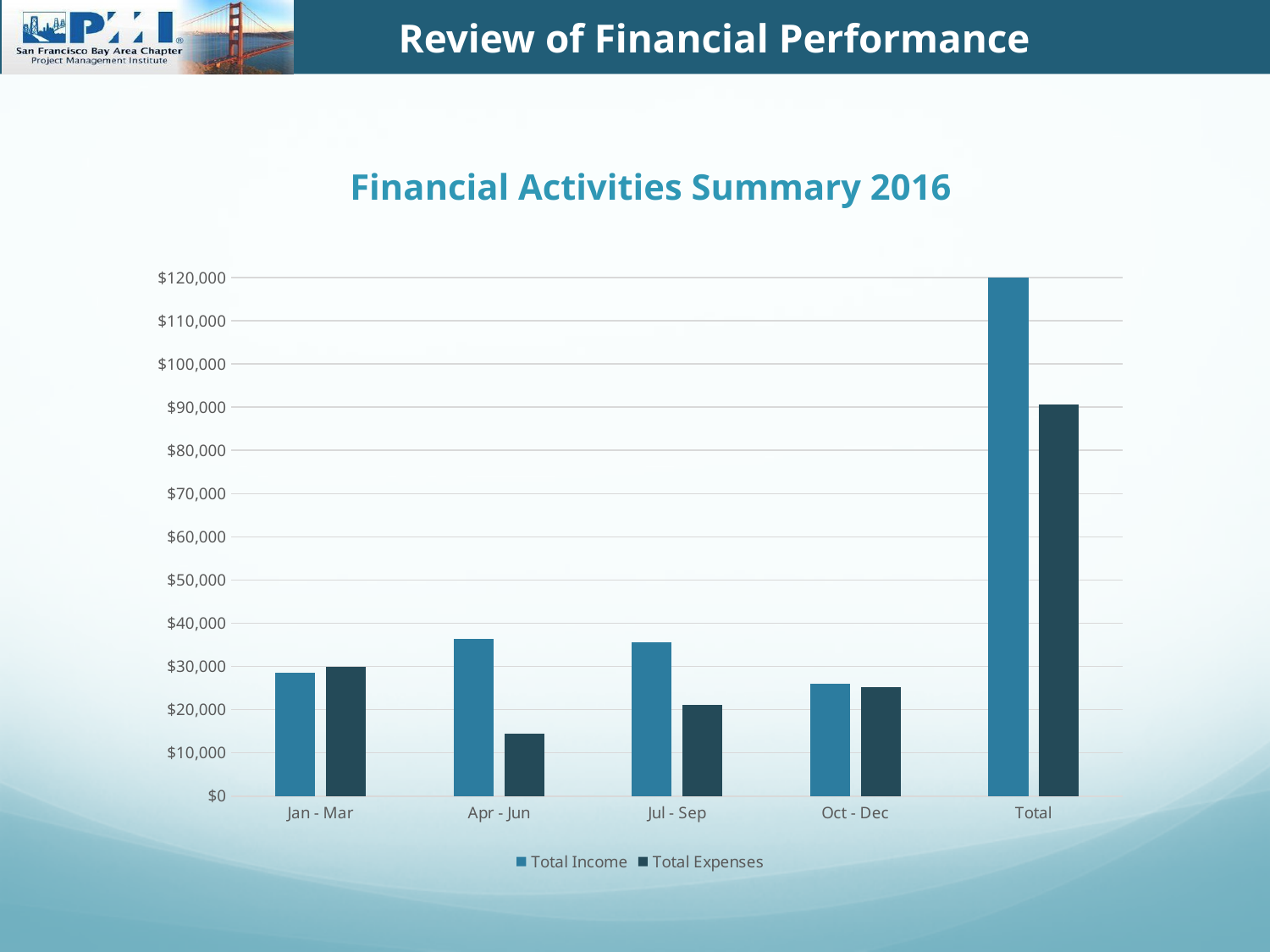
For Jul - Sep, which is larger, Total Income or Total Expenses? Total Income Which quarter has the lowest Total Expenses? Apr - Jun For Apr - Jun, which is larger, Total Income or Total Expenses? Total Income Which category has the highest Total Income bar? Total What is the title of the chart? Financial Activities Summary 2016 How many categories are shown on the x axis? 5 How many series does the legend list? 2 Is the Total Expenses value for the Total category greater or less than $80,000? greater What kind of chart is shown on the slide? bar chart Is the Total Income value for the Total category greater or less than $110,000? greater Is the Total Expenses value for Apr - Jun greater or less than $20,000? less What are the two series named in the legend? Total Income and Total Expenses